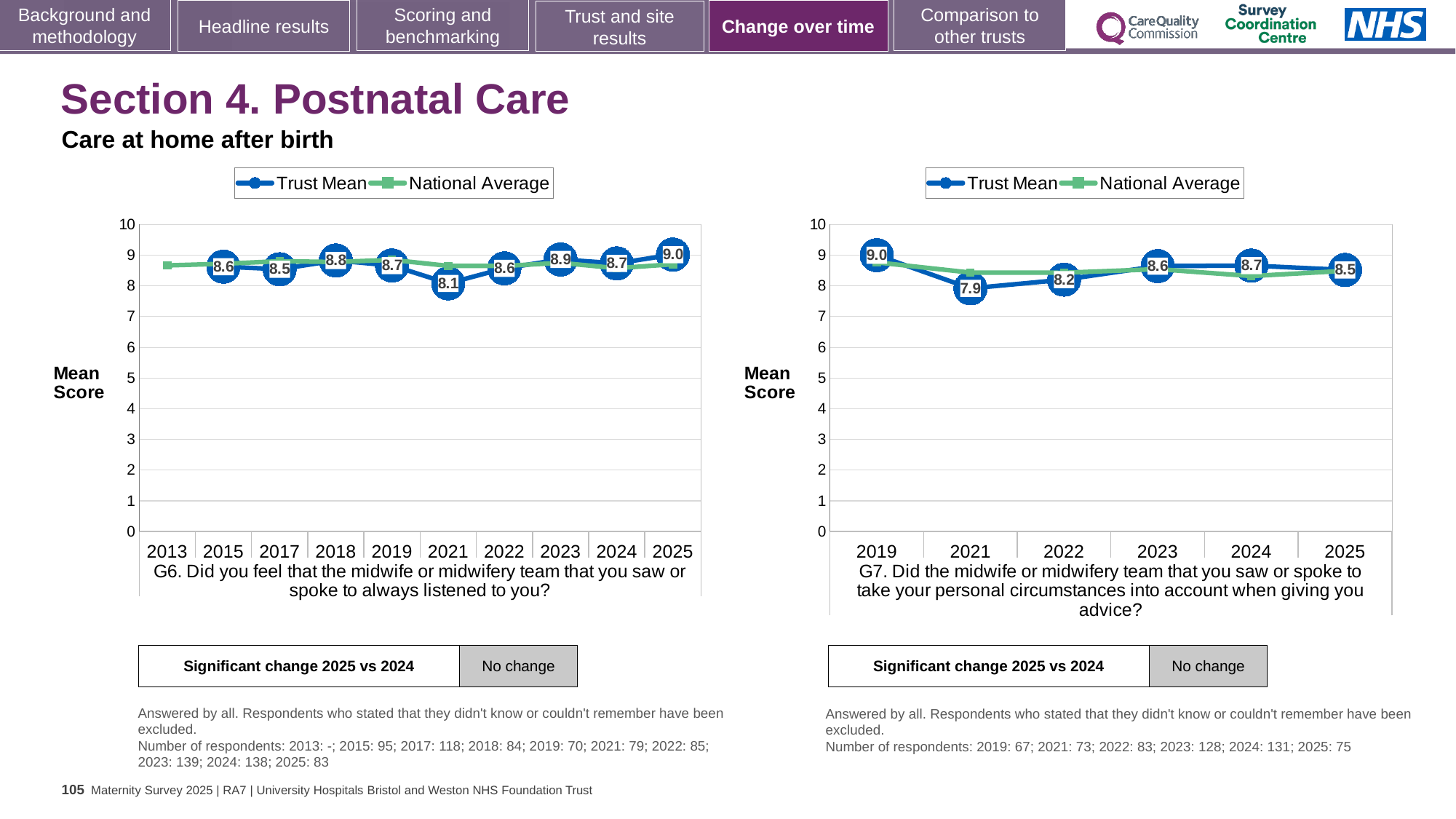
On the left chart (G6), which year has the lowest Trust Mean score? 2021 On the left chart (G6), what is the Trust Mean score for 2025? 9.0 What type of chart is the right chart (G7)? Line chart On the right chart (G7), is the Trust Mean score for 2024 or 2025 larger? 2024 On the right chart (G7), what is the Trust Mean score for 2021? 7.9 On the right chart (G7), which year has the highest Trust Mean score? 2019 On the left chart (G6), what is the Trust Mean score for 2021? 8.1 On the right chart (G7), how many series does the legend list? 2 On the right chart (G7), what is the difference between the Trust Mean scores for 2019 and 2021? 1.1 On the left chart (G6), how many years are shown on the x axis? 10 On the left chart (G6), what is the difference between the Trust Mean scores for 2025 and 2021? 0.9 On the left chart (G6), which year has the highest Trust Mean score? 2025